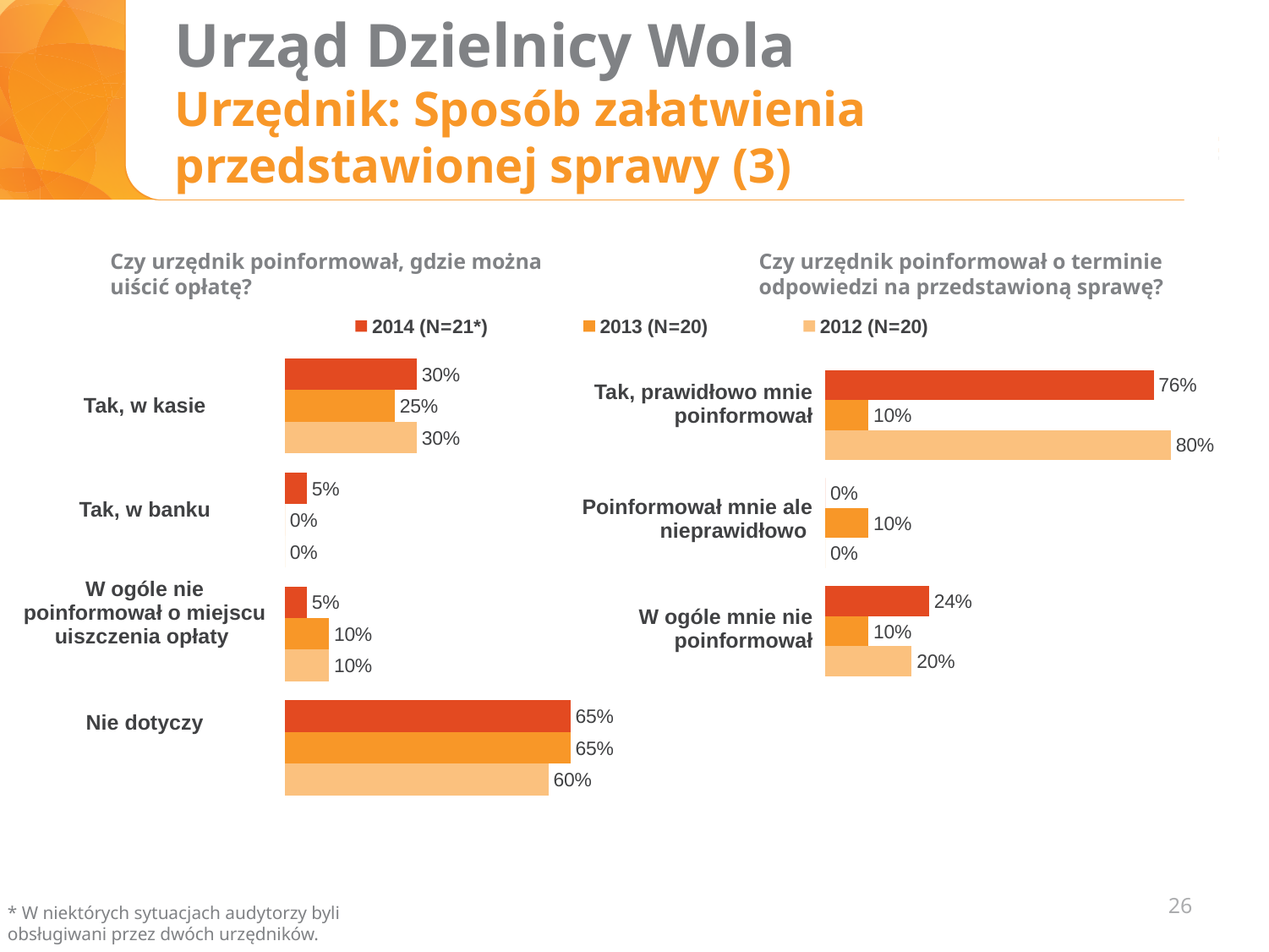
In the right chart ('Czy urzędnik poinformował o terminie odpowiedzi na przedstawioną sprawę?'), what is the difference between the 2012 (N=20) and 2013 (N=20) values for 'Tak, prawidłowo mnie poinformował'? 70% In the right chart ('Czy urzędnik poinformował o terminie odpowiedzi na przedstawioną sprawę?'), which category has the lowest value for 2014 (N=21*)? Poinformował mnie ale nieprawidłowo How many categories does the left chart ('Czy urzędnik poinformował, gdzie można uiścić opłatę?') show? 4 What kind of chart is the right chart ('Czy urzędnik poinformował o terminie odpowiedzi na przedstawioną sprawę?')? Bar chart In the right chart ('Czy urzędnik poinformował o terminie odpowiedzi na przedstawioną sprawę?'), what is the value for 'Tak, prawidłowo mnie poinformował' in 2014 (N=21*)? 76% In the left chart ('Czy urzędnik poinformował, gdzie można uiścić opłatę?'), which category has the highest value for 2014 (N=21*)? Nie dotyczy In the right chart ('Czy urzędnik poinformował o terminie odpowiedzi na przedstawioną sprawę?'), what is the value for 'W ogóle mnie nie poinformował' in 2012 (N=20)? 20% In the left chart ('Czy urzędnik poinformował, gdzie można uiścić opłatę?'), which is larger for 'W ogóle nie poinformował o miejscu uiszczenia opłaty': the 2014 (N=21*) value or the 2013 (N=20) value? 2013 (N=20) In the left chart ('Czy urzędnik poinformował, gdzie można uiścić opłatę?'), what is the value for 'Nie dotyczy' in 2012 (N=20)? 60% In the left chart ('Czy urzędnik poinformował, gdzie można uiścić opłatę?'), what is the value for 'Tak, w kasie' in 2013 (N=20)? 25% How many series does the legend list? 3 In the right chart ('Czy urzędnik poinformował o terminie odpowiedzi na przedstawioną sprawę?'), what is the total of the three series values for 'W ogóle mnie nie poinformował'? 54%